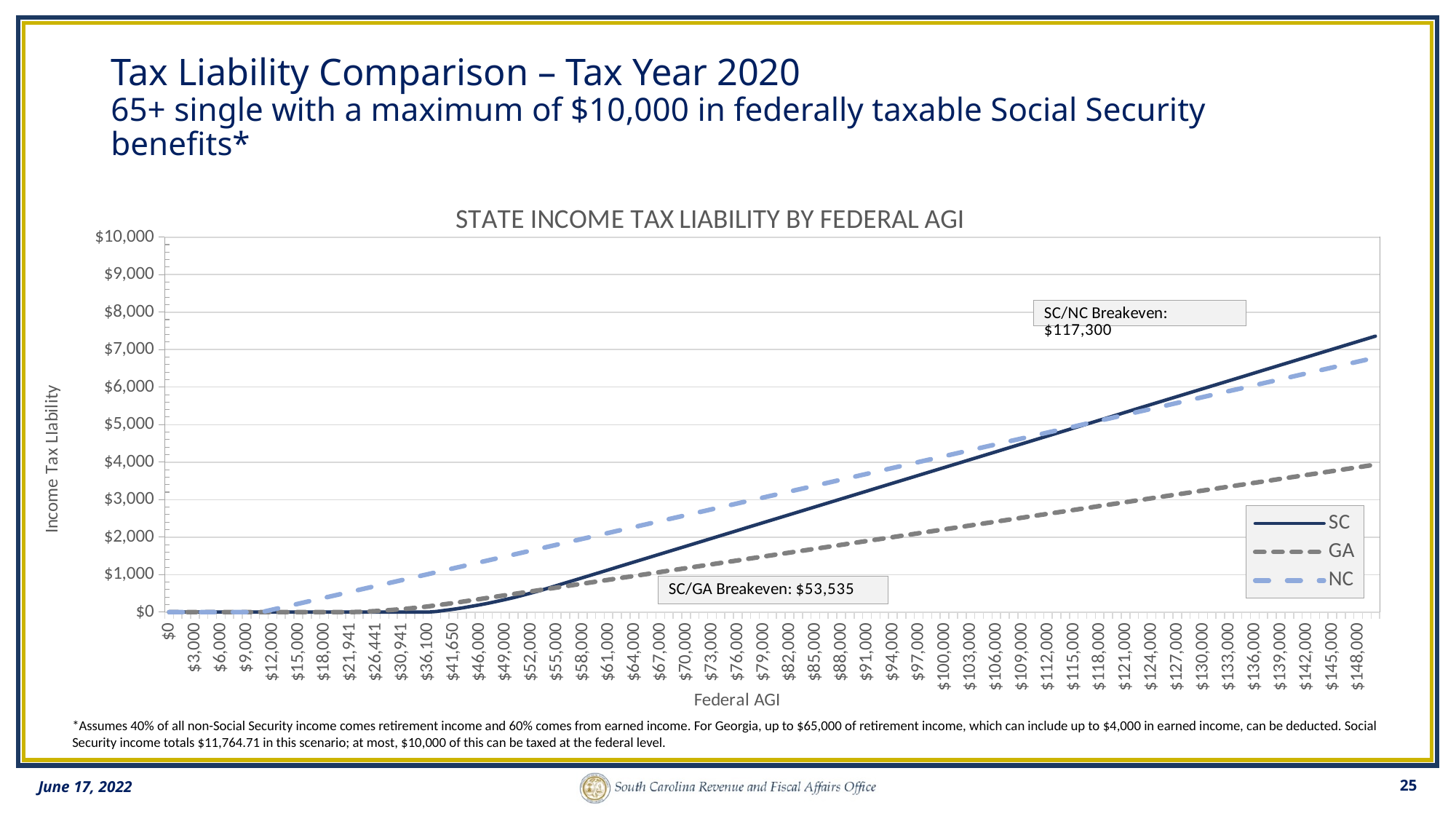
At what federal AGI does the chart mark the SC/GA breakeven? $53,535 How many series does the chart legend list? 3 Which series are listed in the chart legend? SC, GA, NC Is the GA income tax liability at a federal AGI of $148,000 greater or less than $3,000? greater Do the income tax liability values for SC rise or fall as federal AGI increases along the x axis? rise Which series has the lowest income tax liability at a federal AGI of $148,000? GA At what federal AGI does the chart mark the SC/NC breakeven? $117,300 At a federal AGI of $100,000, which series has the larger income tax liability, SC or NC? NC Which series has the highest income tax liability at a federal AGI of $148,000? SC What is the title of the chart? STATE INCOME TAX LIABILITY BY FEDERAL AGI What type of chart is shown on the slide? Line chart Is the SC income tax liability at a federal AGI of $148,000 greater or less than $7,000? greater